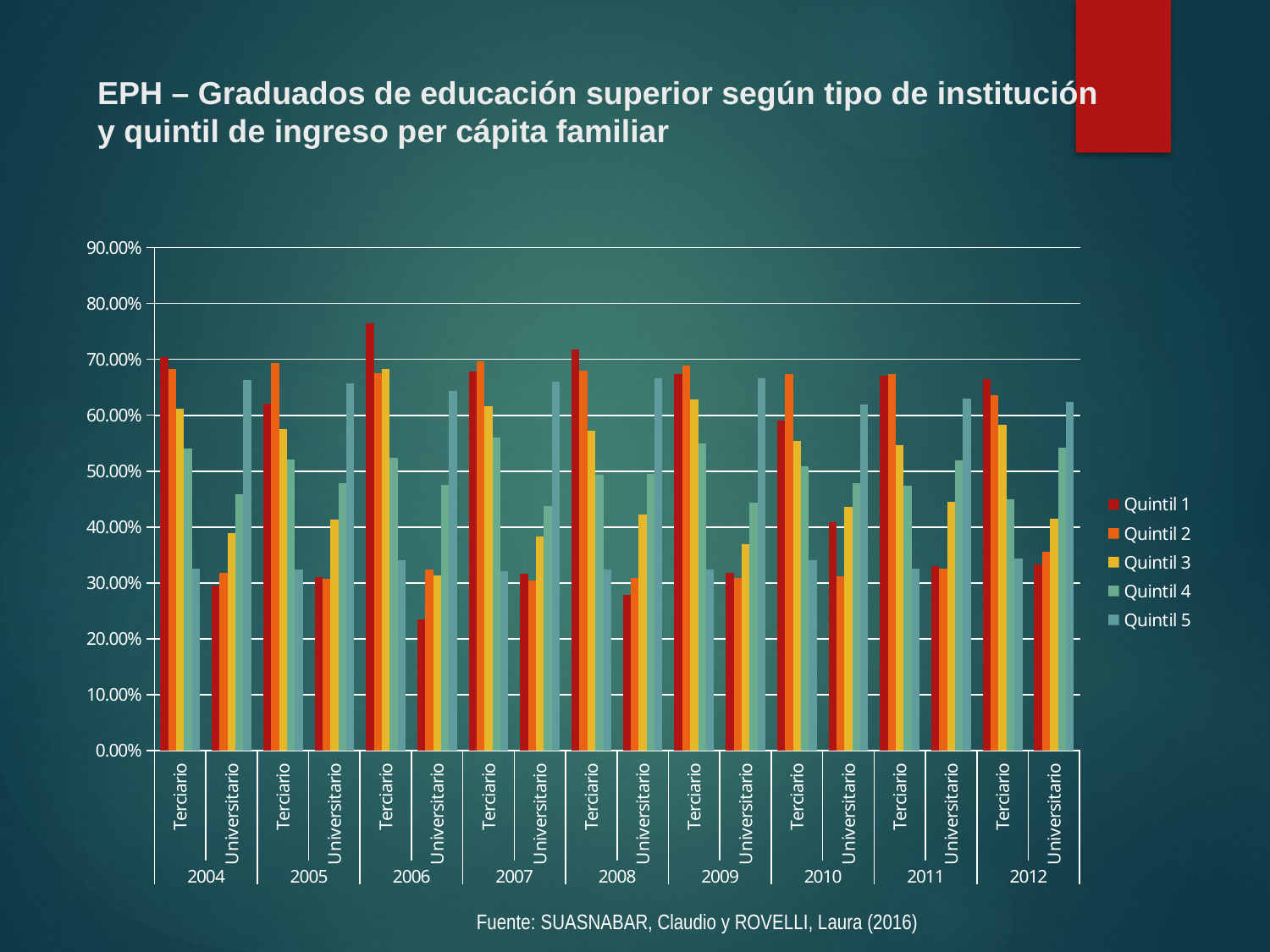
For Universitario in 2004, which is larger: Quintil 1 or Quintil 5? Quintil 5 In which year is the Quintil 1 bar for Universitario the lowest? 2006 Is the value for Quintil 5 in Universitario 2004 greater or less than 60.00%? greater What source is cited below the chart? SUASNABAR, Claudio y ROVELLI, Laura (2016) Is the value for Quintil 1 in Universitario 2006 greater or less than 30.00%? less Is the value for Quintil 1 in Universitario 2008 greater or less than 30.00%? less How many category groups (year and institution type combinations) are shown along the x axis? 18 How many series does the legend list? 5 How many years are shown along the x axis? 9 What kind of chart is shown on the slide? bar chart In which year is the Quintil 1 bar for Terciario the highest? 2006